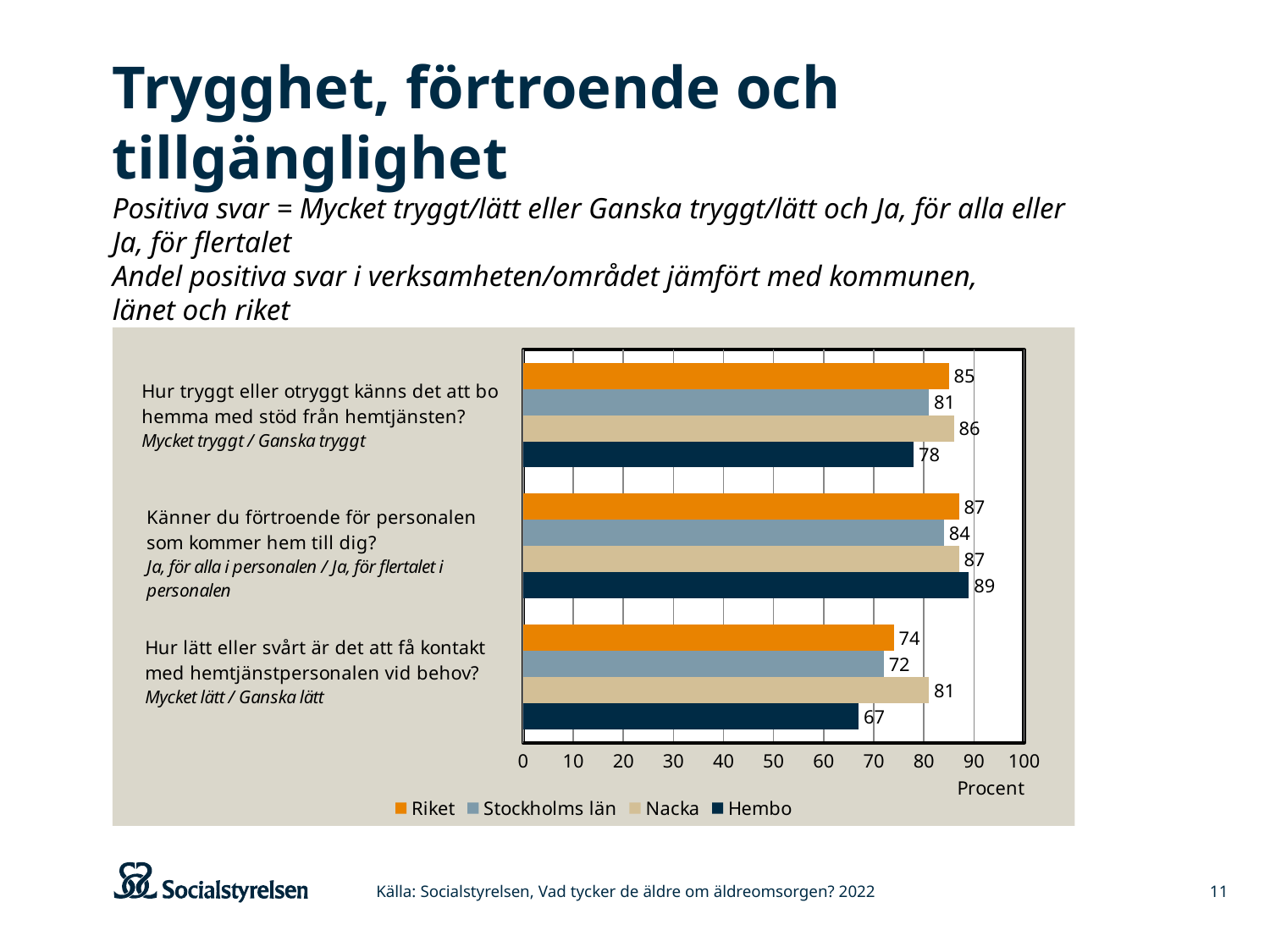
What is the difference between Riket and Hembo on the question 'Hur tryggt eller otryggt känns det att bo hemma med stöd från hemtjänsten?' 7 What kind of chart is shown on the slide? Bar chart Which is larger on the question 'Hur tryggt eller otryggt känns det att bo hemma med stöd från hemtjänsten?': Riket or Stockholms län? Riket What is the value for Stockholms län on the question 'Känner du förtroende för personalen som kommer hem till dig?' 84 Which series has the lowest value on the question 'Hur lätt eller svårt är det att få kontakt med hemtjänstpersonalen vid behov?' Hembo Which series has the highest value on the question 'Känner du förtroende för personalen som kommer hem till dig?' Hembo What is the value for Nacka on the question 'Hur lätt eller svårt är det att få kontakt med hemtjänstpersonalen vid behov?' 81 How many series does the legend list? 4 What is the value for Hembo on the question 'Hur tryggt eller otryggt känns det att bo hemma med stöd från hemtjänsten?' 78 How many question categories are plotted on the chart? 3 What is the difference between Nacka and Hembo on the question 'Hur lätt eller svårt är det att få kontakt med hemtjänstpersonalen vid behov?' 14 What unit label is shown on the x axis of the chart? Procent